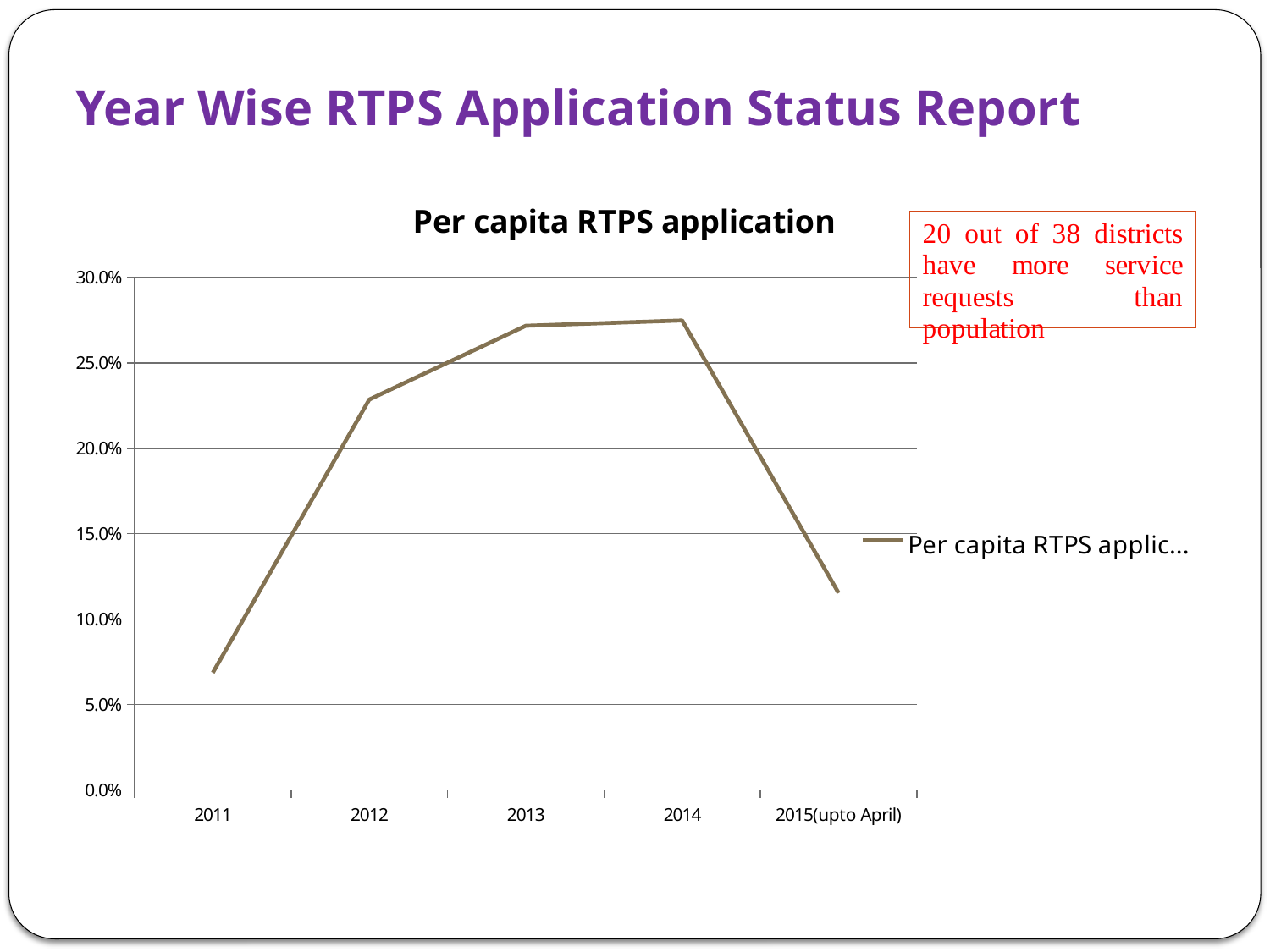
Is the value for 2012 greater or less than 20.0%? greater How many years (data points) are plotted along the x axis? 5 How many series does the legend list? 1 Is the value for 2013 greater or less than 25.0%? greater What kind of chart is shown on the slide? line chart Which is larger, the value for 2011 or the value for 2015(upto April)? 2015(upto April) Which year has the lowest per capita RTPS application value? 2011 Is the value for 2011 greater or less than 10.0%? less Does the line rise or fall between 2014 and 2015(upto April)? fall Which is larger, the value for 2012 or the value for 2015(upto April)? 2012 What is the title of the chart? Per capita RTPS application